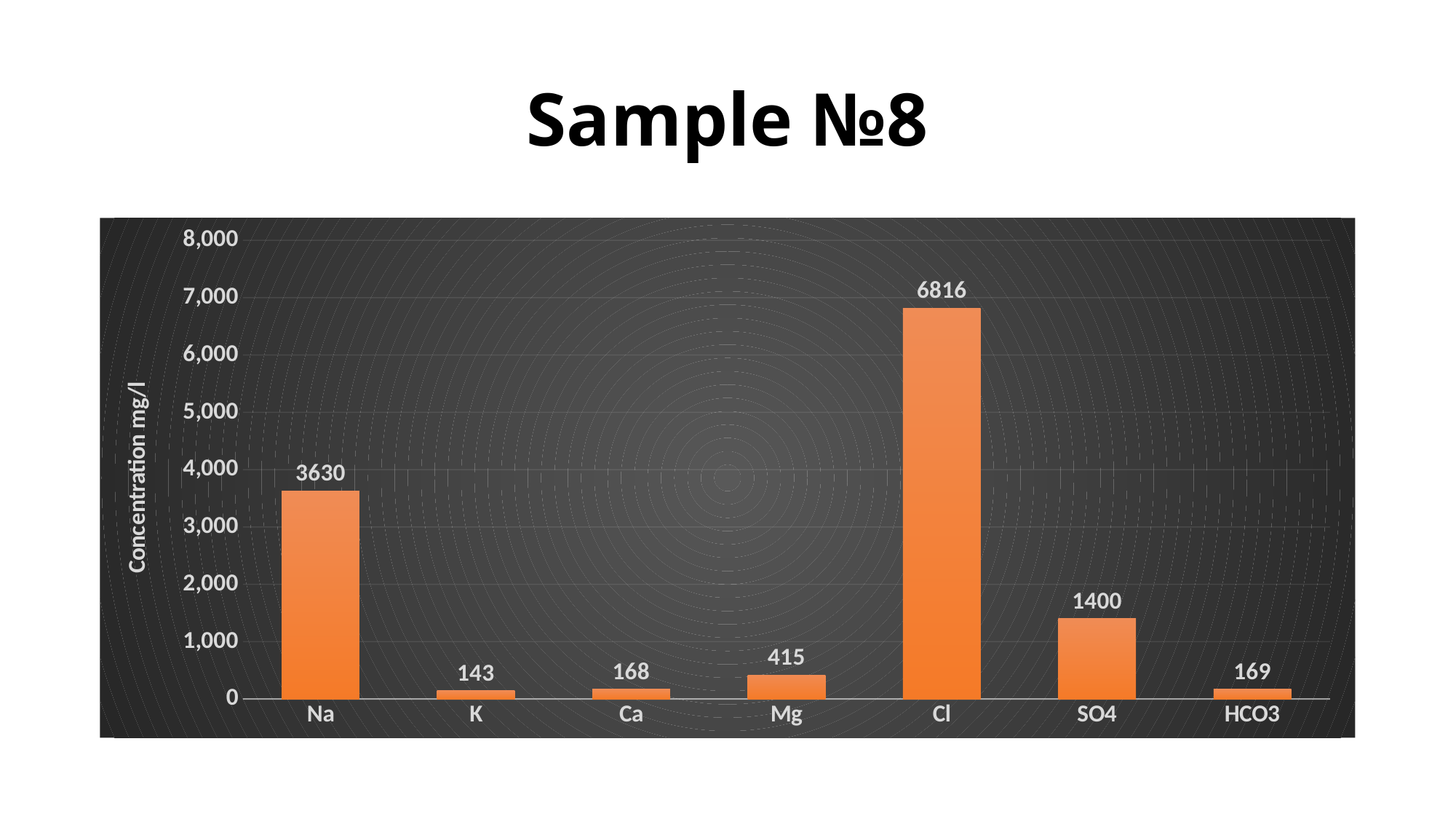
Which ion has the lowest concentration? K What is the label of the vertical axis? Concentration mg/l What is the difference between the HCO3 and Ca values? 1 What is the difference between the Cl and Na concentrations? 3186 Which is larger, the value for SO4 or the value for Mg? SO4 Which ion has the highest concentration? Cl What is the value for Mg? 415 How many ions are plotted on the chart? 7 What is the concentration of Na shown on the chart? 3630 What value is shown for SO4? 1400 What is the concentration of Cl in Sample №8? 6816 What kind of chart is shown on the slide? Bar chart